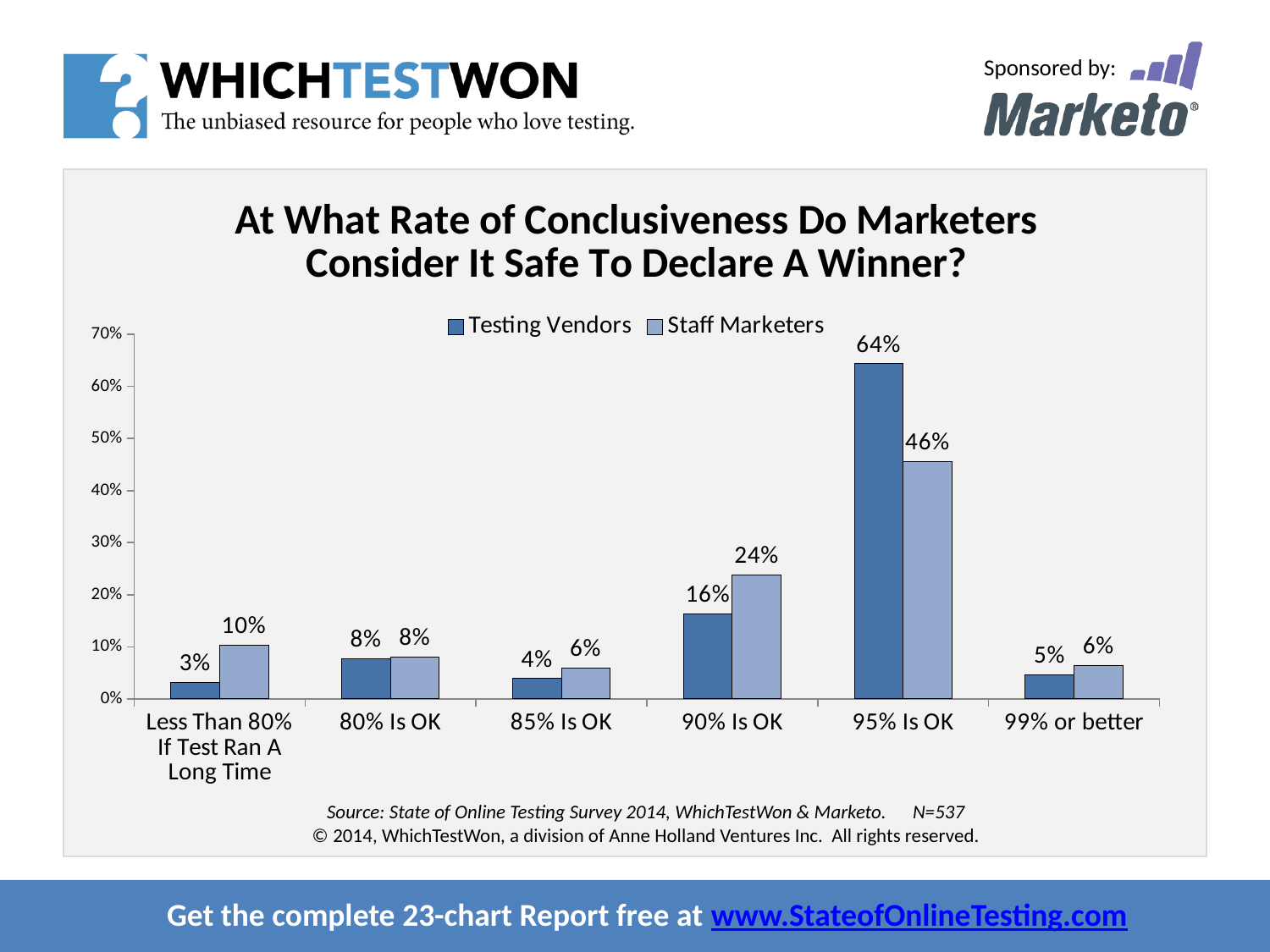
For '90% Is OK', which series has the larger value, Testing Vendors or Staff Marketers? Staff Marketers Which category has the highest value for Staff Marketers? 95% Is OK How many series does the legend list? 2 How many categories are shown on the x axis? 6 What kind of chart is shown on the slide? Bar chart What is the difference between Testing Vendors and Staff Marketers for '95% Is OK'? 18% What is the Testing Vendors value for 'Less Than 80% If Test Ran A Long Time'? 3% What is the title of the chart? At What Rate of Conclusiveness Do Marketers Consider It Safe To Declare A Winner? What percentage of Testing Vendors consider 95% conclusiveness OK? 64% What percentage of Staff Marketers consider 90% conclusiveness OK? 24% Which category has the lowest value for Testing Vendors? Less Than 80% If Test Ran A Long Time Is the Testing Vendors value for '95% Is OK' greater or less than 60%? greater